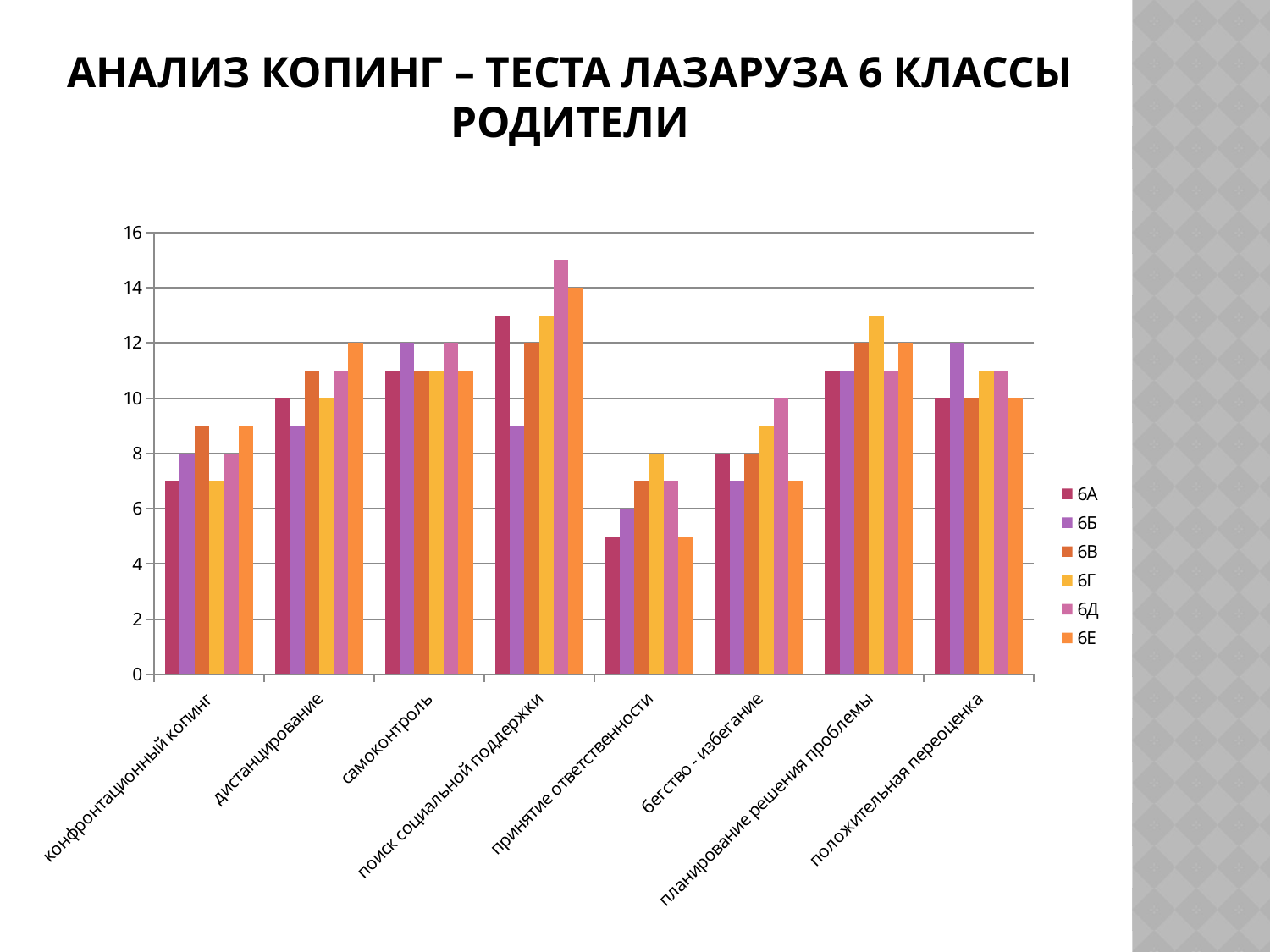
Which series has the highest value in the category поиск социальной поддержки? 6Д What is the value for 6Б in the category самоконтроль? 12 What is the difference between the values for 6Е and 6А in the category дистанцирование? 2 How many categories are shown on the x axis? 8 What is the value for 6Г in the category принятие ответственности? 8 What is the value for 6Е in the category дистанцирование? 12 What is the value for 6Е in the category поиск социальной поддержки? 14 Which series is listed first in the legend? 6А Is the value for 6А in the category поиск социальной поддержки greater or less than 12? greater How many series does the legend list? 6 What type of chart is shown on the slide? bar chart Which is larger in the category поиск социальной поддержки: 6Д or 6Б? 6Д